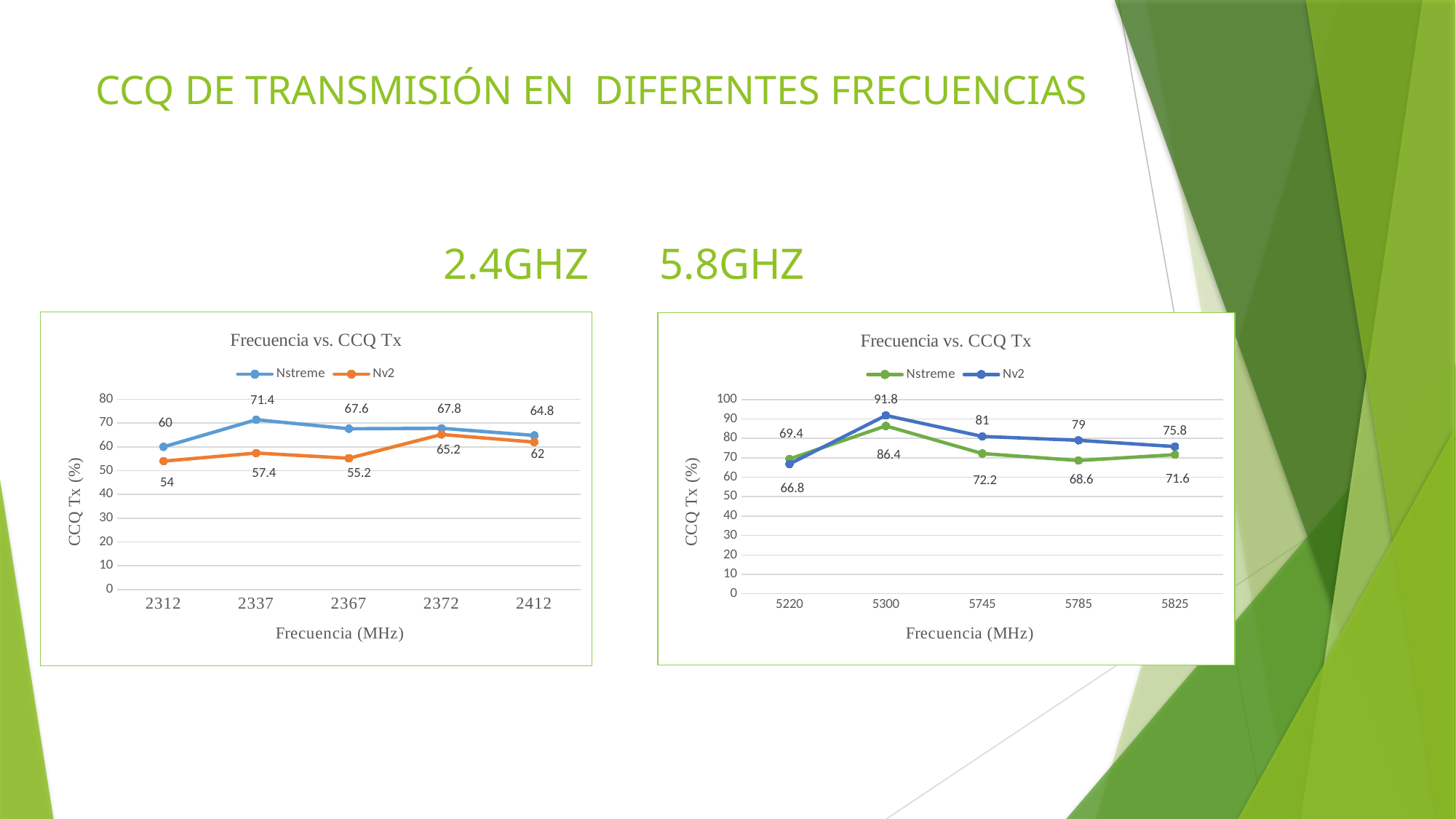
In the 2.4GHZ chart on the left, what is the difference between the Nstreme and Nv2 values at 2312 MHz? 6 In the 2.4GHZ chart on the left, what is the Nv2 value at 2372 MHz? 65.2 In the 5.8GHZ chart on the right, at which frequency is the Nstreme value highest? 5300 What type of chart is the 2.4GHZ chart on the left? Line chart In the 5.8GHZ chart on the right, what is the Nv2 value at 5300 MHz? 91.8 In the 5.8GHZ chart on the right, what is the difference between the Nv2 and Nstreme values at 5825 MHz? 4.2 In the 2.4GHZ chart on the left, at which frequency is the Nv2 value lowest? 2312 In the 5.8GHZ chart on the right, what is the Nstreme value at 5785 MHz? 68.6 How many frequency points are plotted in the 5.8GHZ chart on the right? 5 In the 2.4GHZ chart on the left, what is the Nstreme value at 2337 MHz? 71.4 In the 5.8GHZ chart on the right, which series has the larger value at 5745 MHz, Nstreme or Nv2? Nv2 In the 2.4GHZ chart on the left, how many series does the legend list? 2